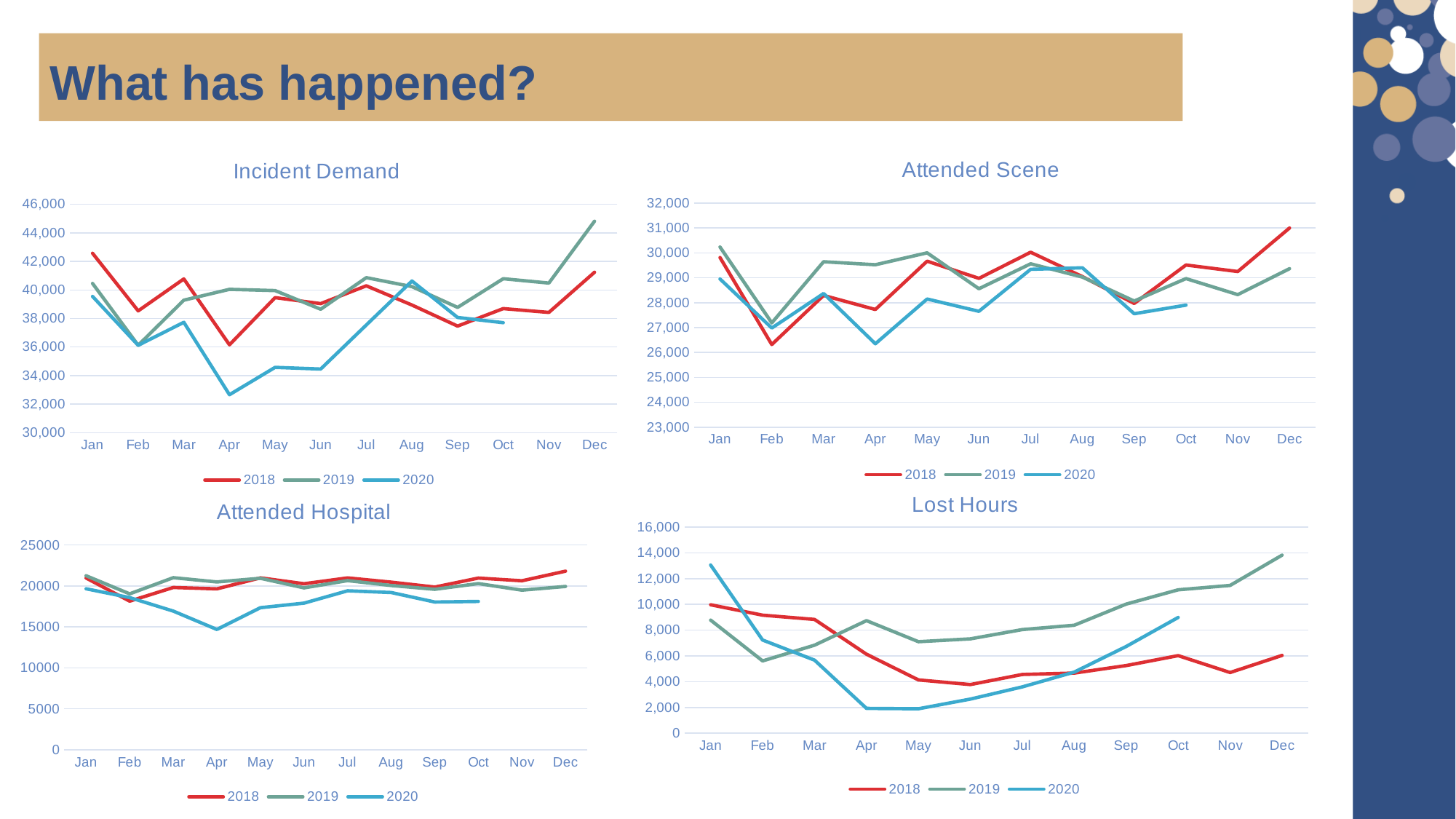
In the Attended Hospital chart, which month has the lowest 2020 value? Apr In the Lost Hours chart, which is larger in Jan: the 2020 value or the 2018 value? 2020 How many series does the legend of the Lost Hours chart list? 3 In the Incident Demand chart, which month has the highest 2019 value? Dec What kind of chart is the Incident Demand chart? line chart How many months are shown on the x axis of the Attended Hospital chart? 12 What is the title of the chart in the top right of the slide? Attended Scene In the Incident Demand chart, which month has the lowest 2020 value? Apr In the Attended Scene chart, is the 2018 value for Dec greater or less than 30,000? greater In the Attended Scene chart, is the 2020 value for Apr greater or less than 27,000? less In the Lost Hours chart, do the 2019 values rise or fall from Jun to Dec? rise In the Incident Demand chart, is the 2020 value for Apr greater or less than 34,000? less